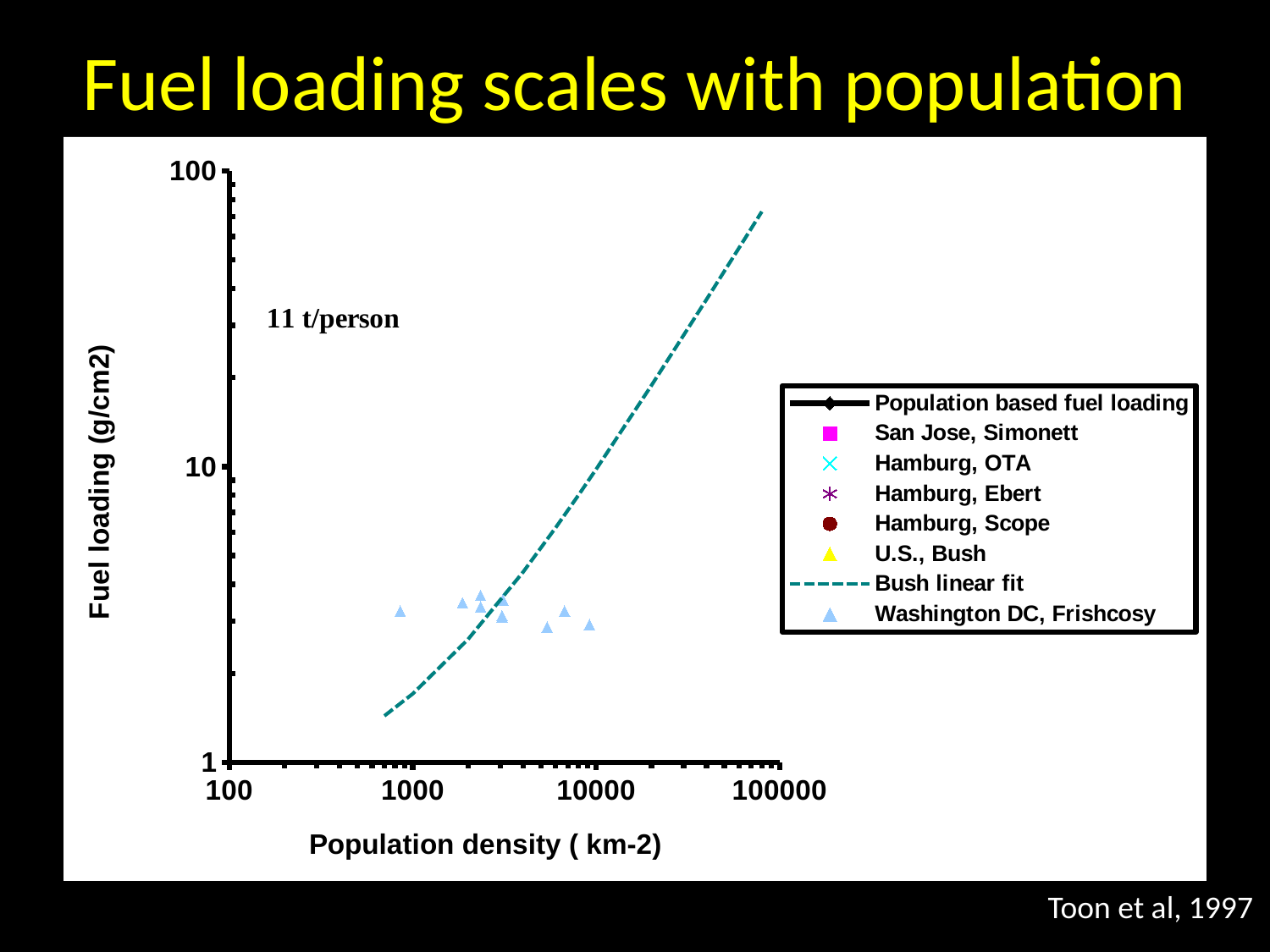
Which is larger: the Bush linear fit value at a population density of 1000 km-2 or at 10000 km-2? At 10000 km-2 Does the Bush linear fit rise or fall as population density increases? Rises Are the Washington DC, Frishcosy fuel loading values greater or less than 10 g/cm2? less What is the highest value shown on the x axis? 100000 Is the Bush linear fit value at a population density of 1000 km-2 greater or less than 10 g/cm2? less What is the label of the y axis? Fuel loading (g/cm2) What kind of chart is shown on the slide? Scatter chart Is the Bush linear fit value at its highest plotted population density greater or less than 10 g/cm2? greater What is the title of the slide's chart? Fuel loading scales with population How many series does the legend list? 8